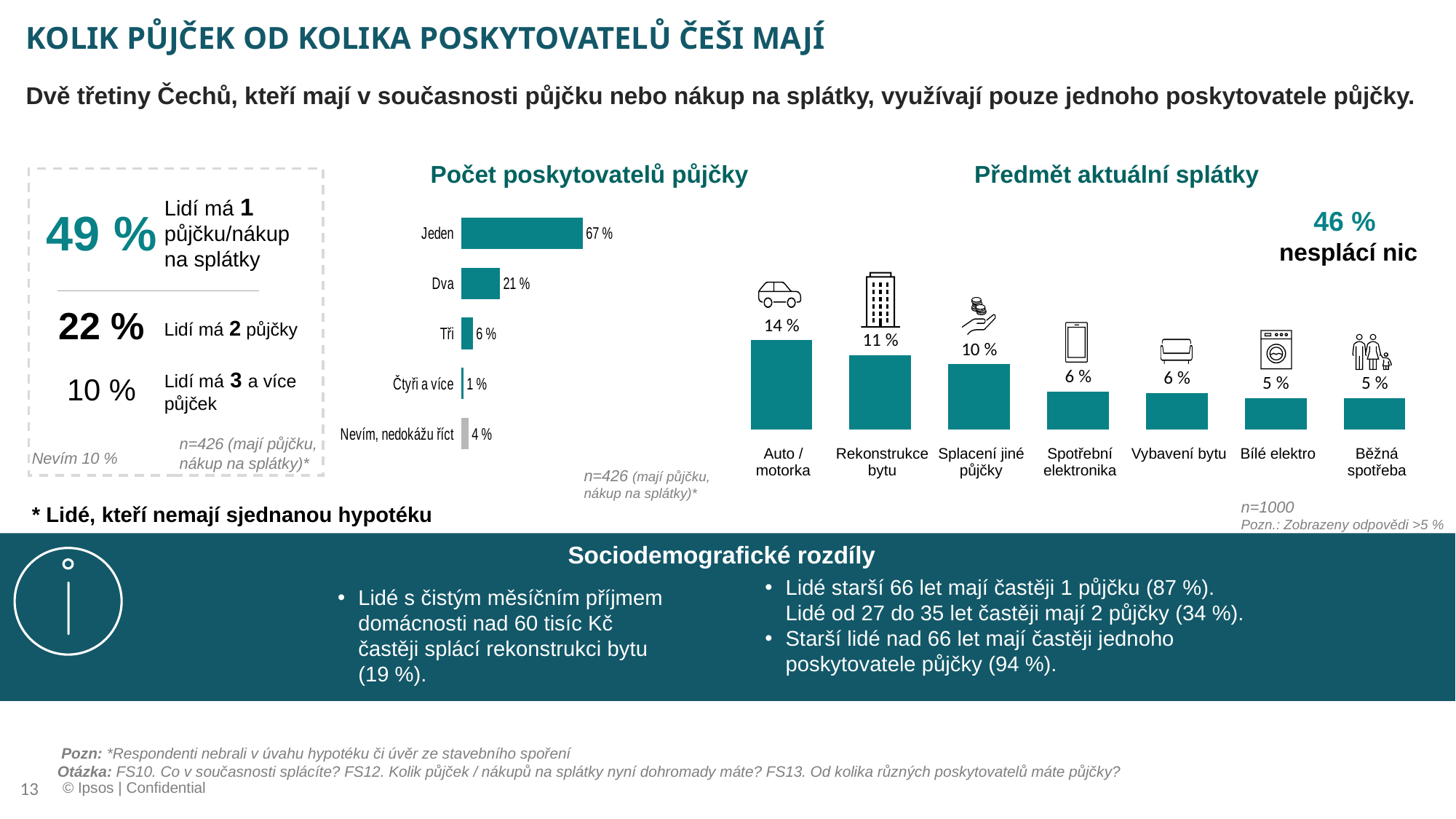
In the chart 'Počet poskytovatelů půjčky', what is the value for 'Jeden'? 67 % In the chart 'Počet poskytovatelů půjčky', which category has the lowest value? Čtyři a více In the chart 'Počet poskytovatelů půjčky', what is the value for 'Dva'? 21 % In the chart 'Předmět aktuální splátky', what is the value for 'Rekonstrukce bytu'? 11 % In the chart 'Předmět aktuální splátky', what is the value for 'Běžná spotřeba'? 5 % In the chart 'Počet poskytovatelů půjčky', how many categories are shown? 5 In the chart 'Předmět aktuální splátky', do the values rise or fall from left to right? Fall What kind of chart is 'Počet poskytovatelů půjčky'? Bar chart In the chart 'Předmět aktuální splátky', which is larger: 'Splacení jiné půjčky' or 'Spotřební elektronika'? Splacení jiné půjčky In the chart 'Předmět aktuální splátky', which category has the highest value? Auto / motorka In the chart 'Předmět aktuální splátky', how many categories are shown? 7 In the chart 'Počet poskytovatelů půjčky', what is the difference between the values for 'Jeden' and 'Dva'? 46 %